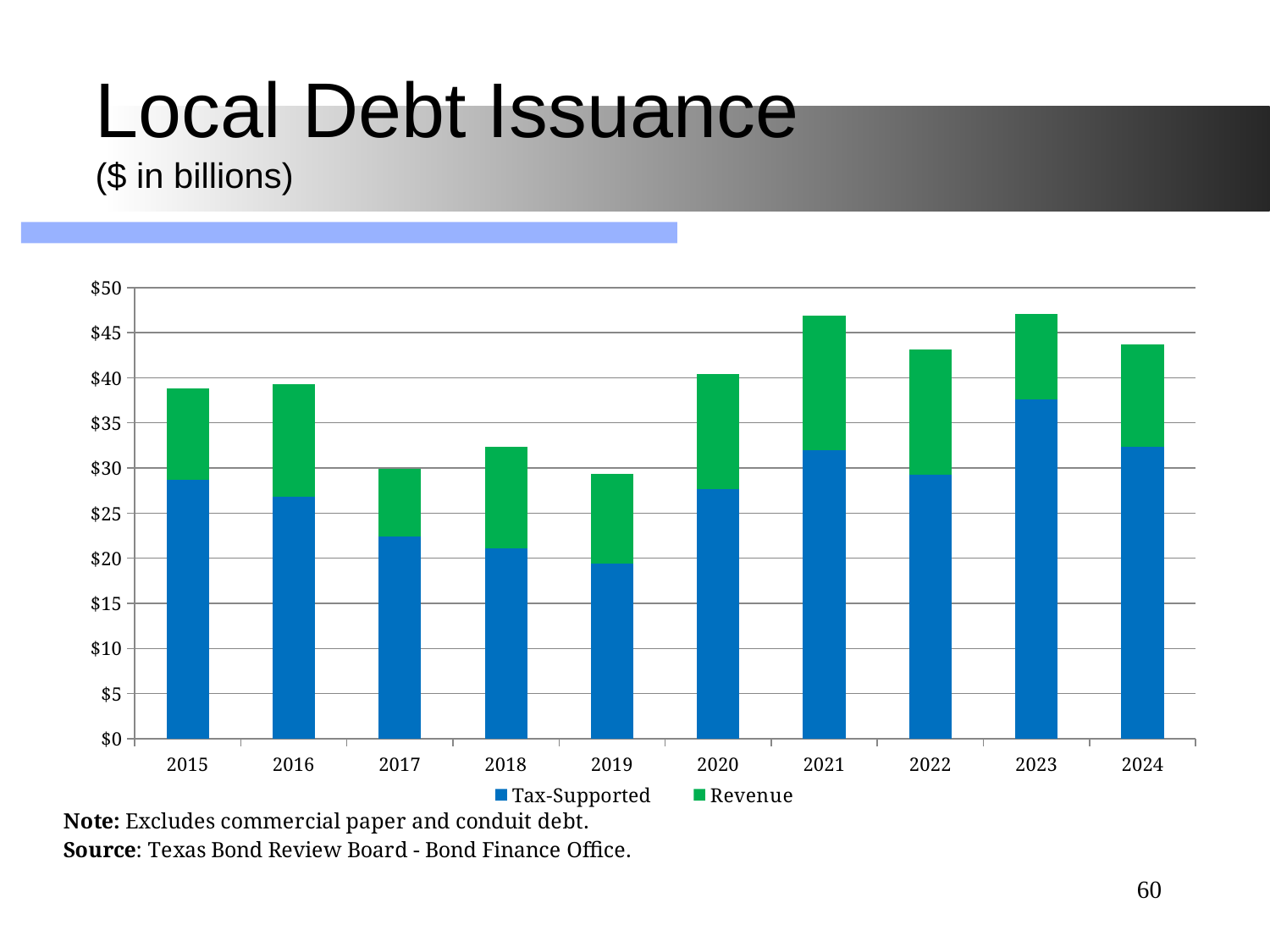
Which is larger, the total bar for 2015 or the total bar for 2017? 2015 What kind of chart is shown on the slide? Stacked bar chart Is the Tax-Supported value for 2015 greater or less than $30? less Which year has the highest Tax-Supported value? 2023 Which year has the lowest Tax-Supported value? 2019 Is the total bar height for 2021 greater or less than $45? greater How many years are shown on the x axis of the chart? 10 How many series does the legend list? 2 What are the two series named in the legend? Tax-Supported and Revenue Is the Tax-Supported value for 2023 greater or less than $35? greater Do the total bar heights rise or fall from 2019 to 2021? rise